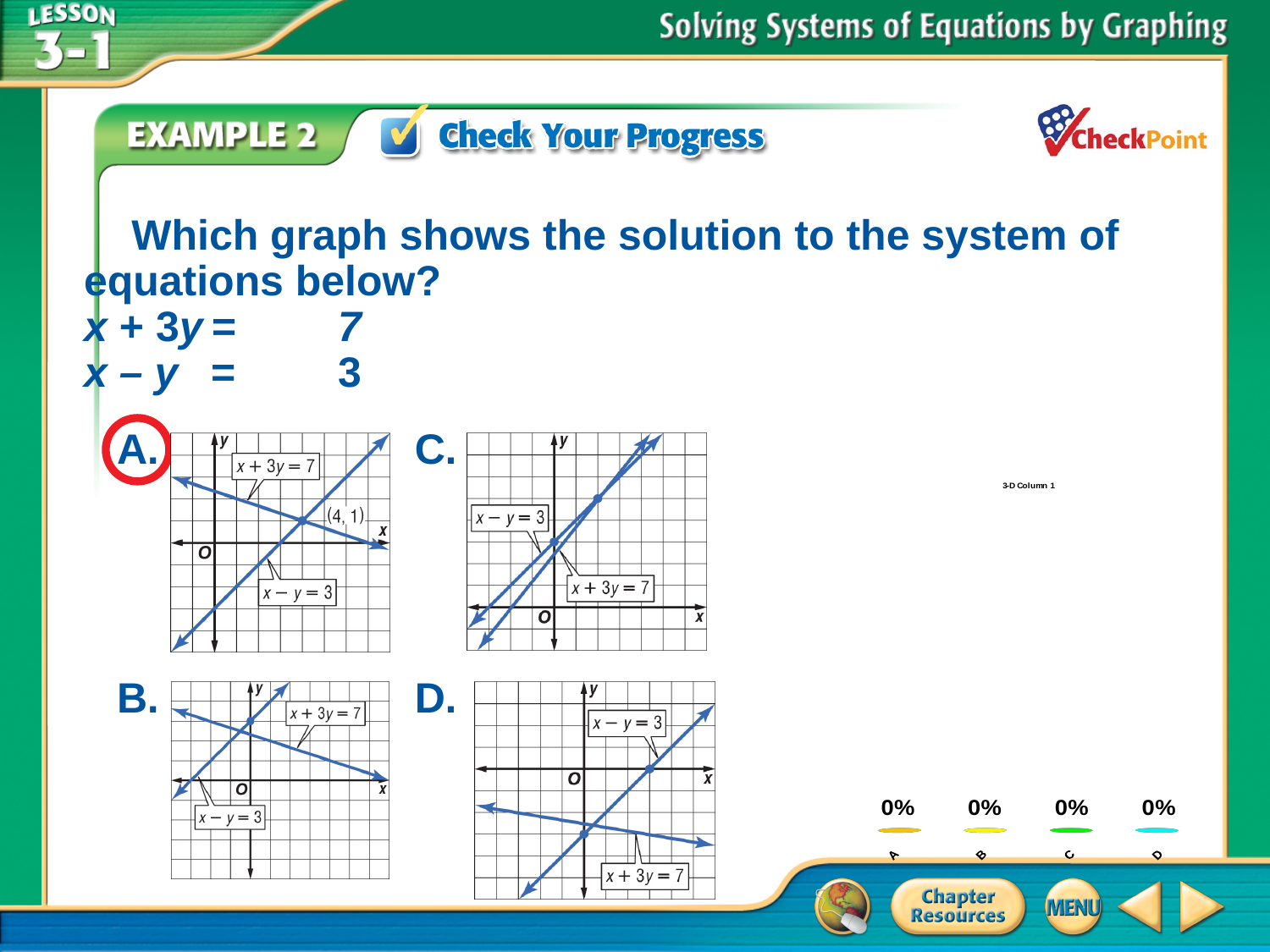
On the poll chart at the bottom right, what is the value shown for category D? 0% On the poll chart at the bottom right, what is the value shown for category B? 0% On the poll chart at the bottom right, what is the value shown for category C? 0% On the poll chart at the bottom right, what is the difference between the values for A and D? 0% On the poll chart at the bottom right, how many categories are shown along the x axis? 4 On the poll chart at the bottom right, what kind of chart is it? bar chart On the poll chart at the bottom right, what is the value shown for category A? 0% On the poll chart at the bottom right, what are the category labels along the x axis? A, B, C, D In graph A (top left), what coordinate point is labeled at the intersection of the two lines? (4, 1)